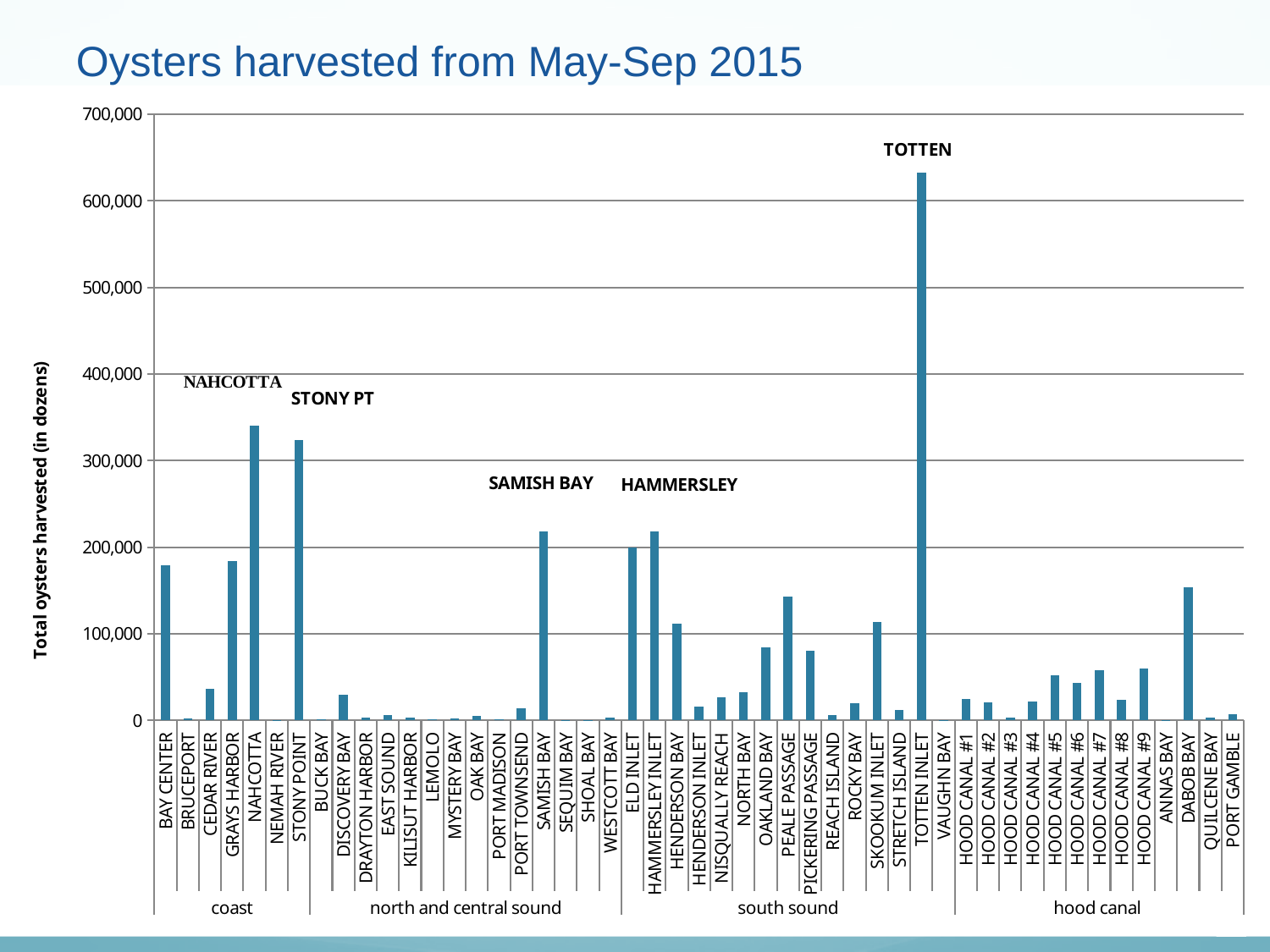
What kind of chart is shown on the slide? bar chart Which has a larger value, Samish Bay or Henderson Bay? Samish Bay How many regional groups are the sites divided into along the x axis? 4 What is the title of the y axis? Total oysters harvested (in dozens) Is the value for Samish Bay greater or less than 200,000? greater Is the value for Oakland Bay greater or less than 100,000? less Which has a larger value, Totten Inlet or Nahcotta? Totten Inlet Is the value for Bay Center greater or less than 200,000? less Which site has the highest total oysters harvested? Totten Inlet